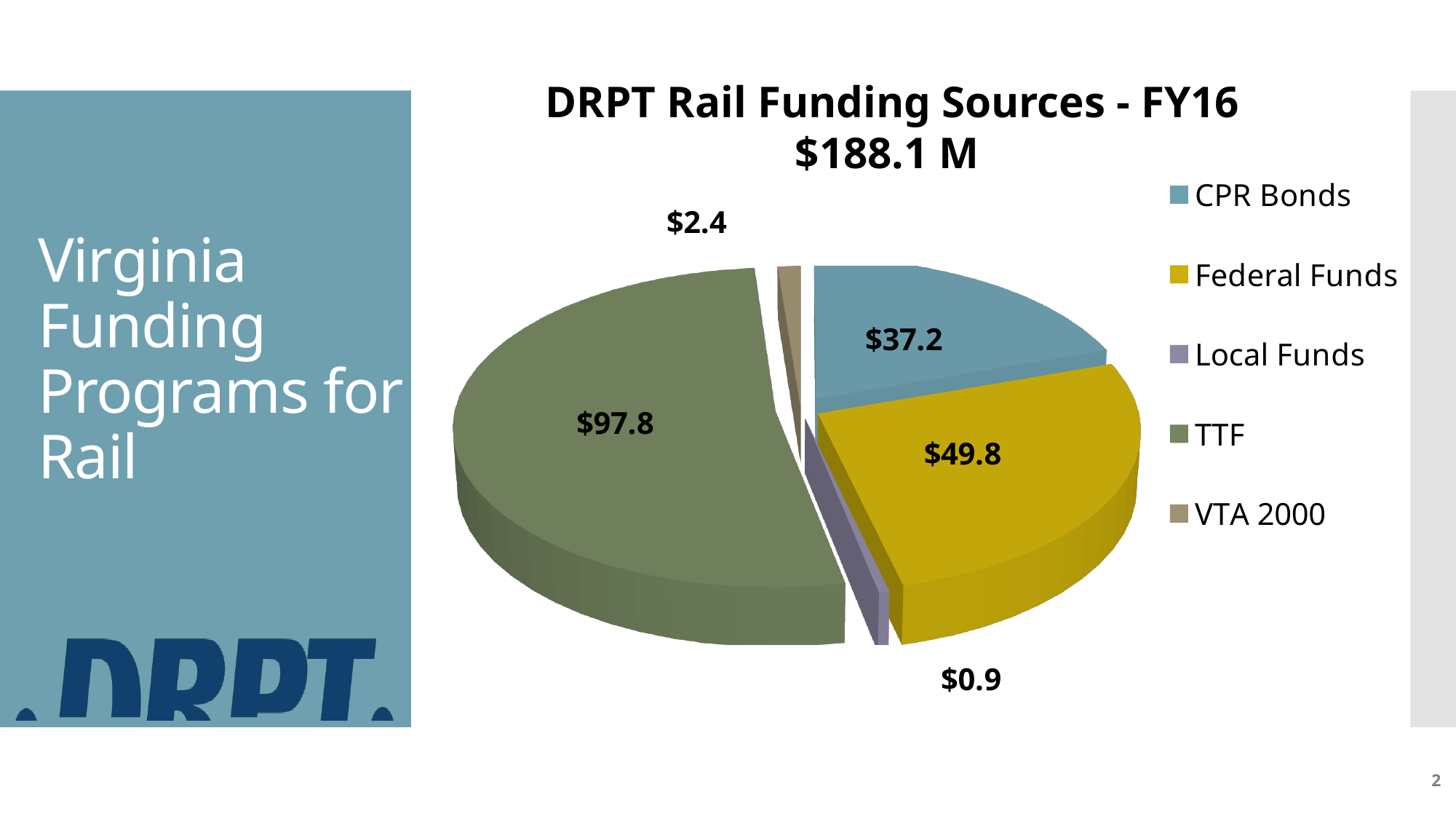
Which funding source has the largest slice? TTF What kind of chart is shown on the slide? Pie chart What is the value for TTF? $97.8 What is the value for Local Funds? $0.9 Which funding source has the smallest slice? Local Funds Which is larger, Federal Funds or CPR Bonds? Federal Funds What is the value for VTA 2000? $2.4 How many funding sources are shown in the pie chart? 5 What is the difference between the TTF value and the Federal Funds value? $48.0 What is the value for Federal Funds? $49.8 What is the value for CPR Bonds? $37.2 What total amount is stated in the chart title? $188.1 M